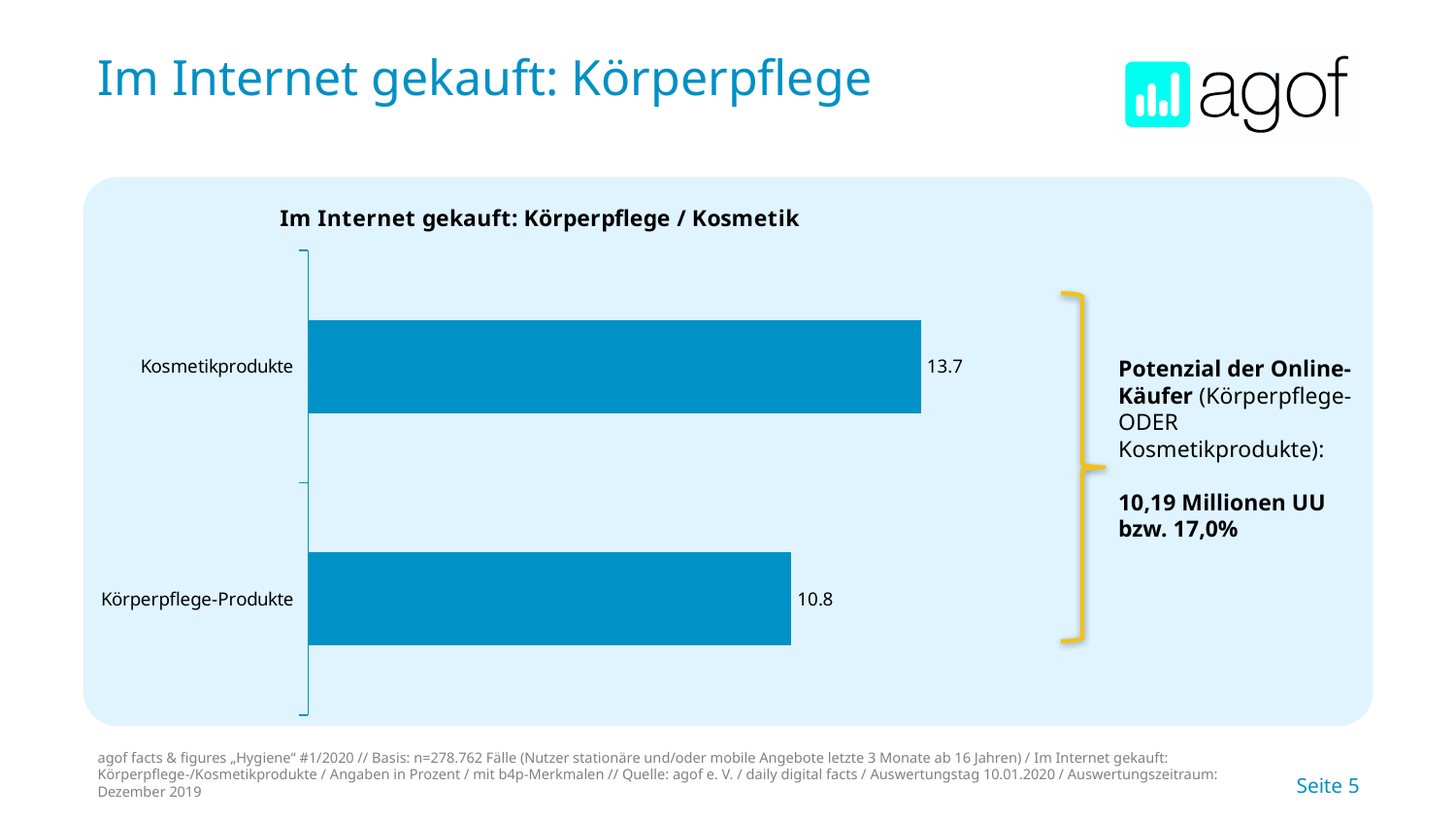
Which category has the highest value? Kosmetikprodukte Which is larger, the value for Kosmetikprodukte or for Körperpflege-Produkte? Kosmetikprodukte What is the value for Körperpflege-Produkte? 10.8 What kind of chart is shown on the slide? Bar chart How many categories are shown in the chart? 2 What is the value for Kosmetikprodukte? 13.7 What is the title of the chart? Im Internet gekauft: Körperpflege / Kosmetik Which category has the lowest value? Körperpflege-Produkte What is the difference between the values for Kosmetikprodukte and Körperpflege-Produkte? 2.9 What colour are the bars in the chart? Blue